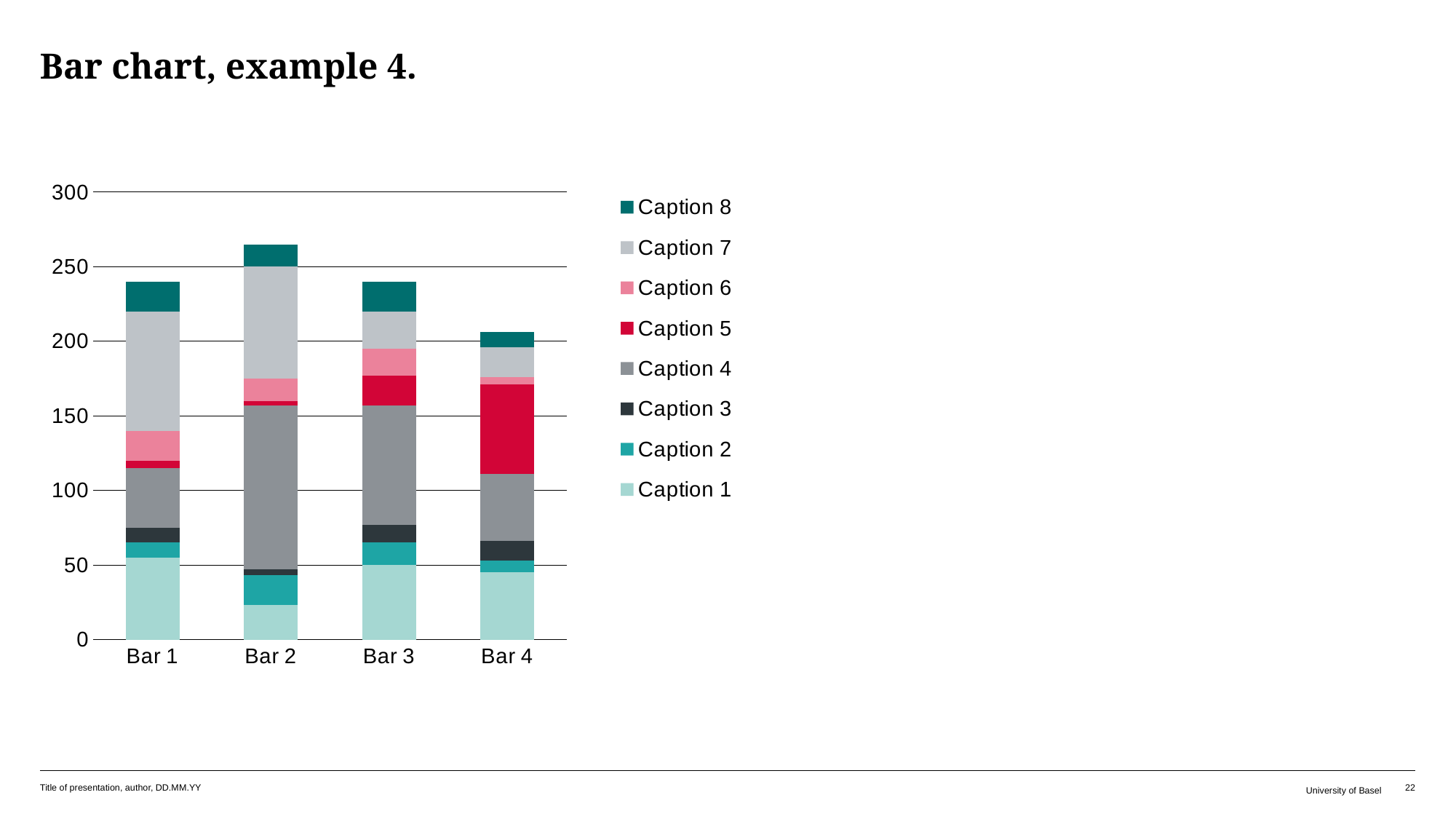
Which bar has the highest total? Bar 2 Which bar has the larger Caption 4 segment, Bar 1 or Bar 2? Bar 2 Is the total for Bar 2 greater or less than 250? greater How many bars (categories) are shown on the x axis? 4 How many series does the legend list? 8 Is the total for Bar 4 greater or less than 250? less What is the title of the slide? Bar chart, example 4. Which bar has the larger Caption 5 segment, Bar 1 or Bar 4? Bar 4 What kind of chart is shown on the slide? Stacked bar chart Which bar has the lowest total? Bar 4 Is the total for Bar 1 greater or less than 250? less